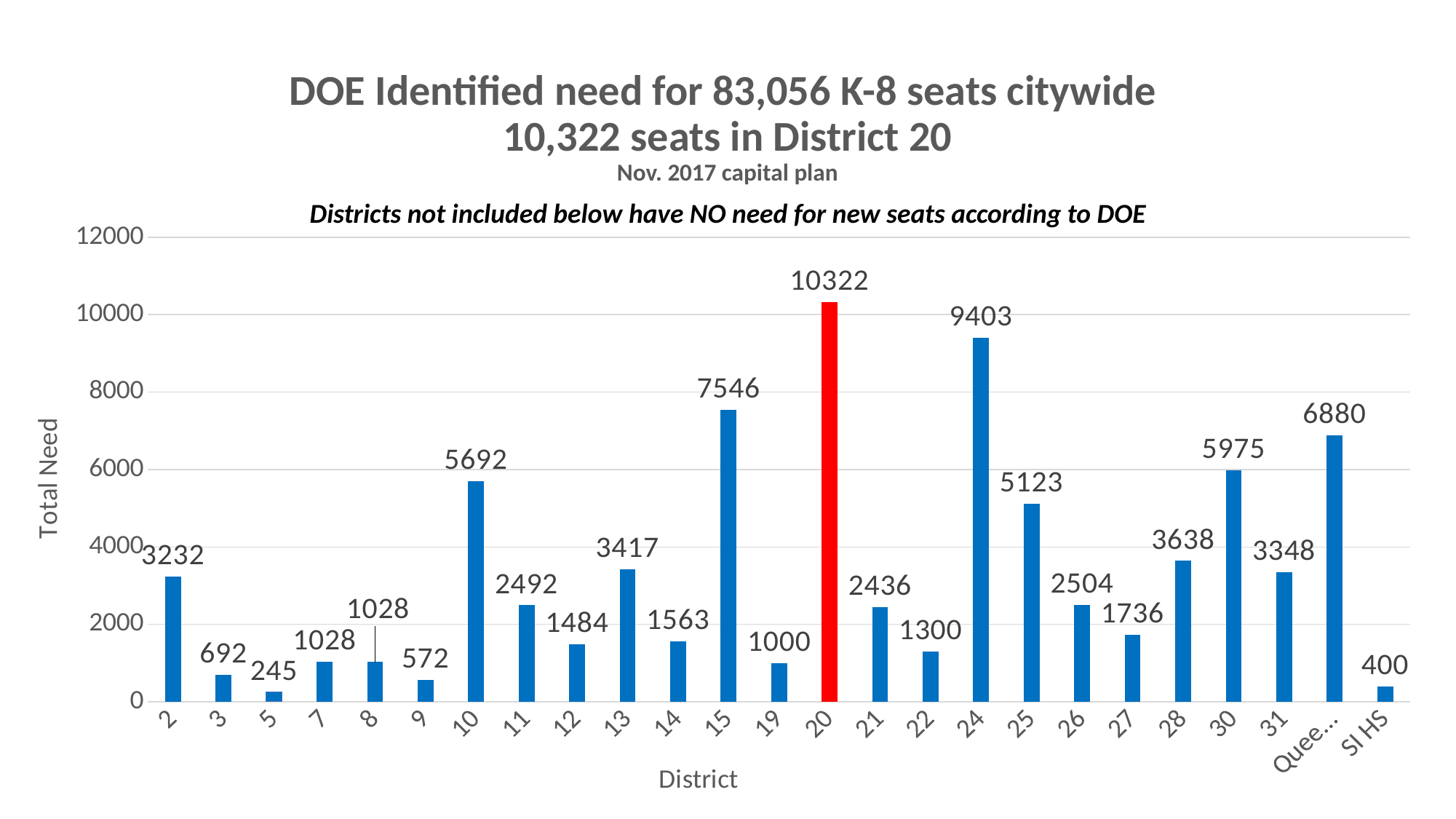
What is the total need for District 24? 9403 What is the total need for District 20? 10322 Which district's bar is coloured red? 20 What is the difference in total need between District 15 and District 10? 1854 What kind of chart is shown on the slide? Bar chart Which district has the lowest total need? 5 What is the total need for District 15? 7546 What is the total need for SI HS? 400 Which has a larger total need, District 30 or District 25? District 30 Which district has the highest total need? 20 What is the difference in total need between District 20 and District 24? 919 How many districts are shown on the x axis? 25